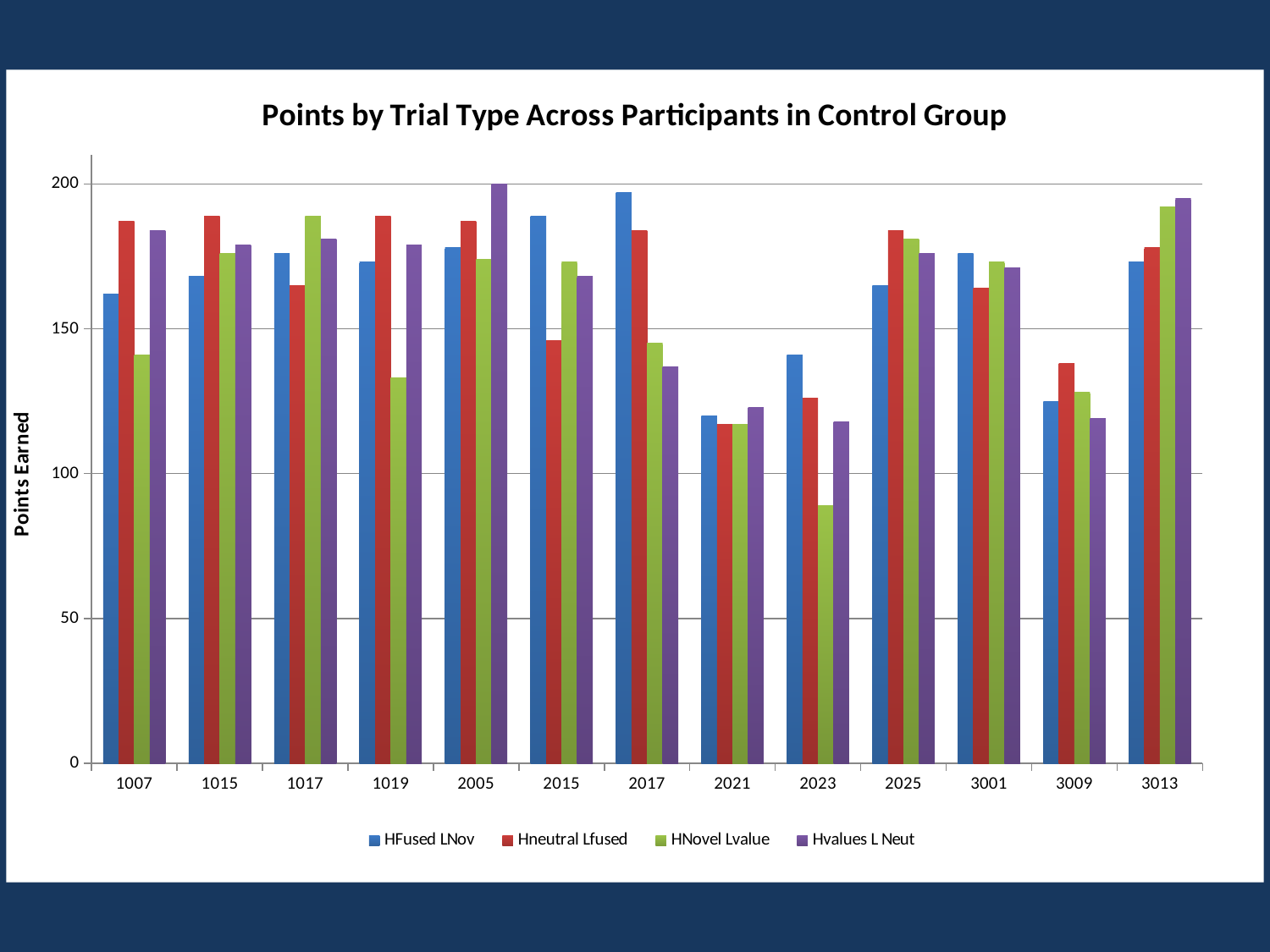
What is the title of the chart? Points by Trial Type Across Participants in Control Group Is the HNovel Lvalue value for participant 2023 greater or less than 100? less Which participant has the highest HFused LNov value? 2017 How many series does the legend list? 4 How many participants (categories) are shown on the x axis? 13 What kind of chart is shown on the slide? bar chart What is the label on the vertical axis? Points Earned Is the HFused LNov value for participant 2017 greater or less than 150? greater For participant 1007, which is larger: Hneutral Lfused or HNovel Lvalue? Hneutral Lfused Is the Hvalues L Neut value for participant 2021 greater or less than 100? greater Which participant has the lowest HNovel Lvalue value? 2023